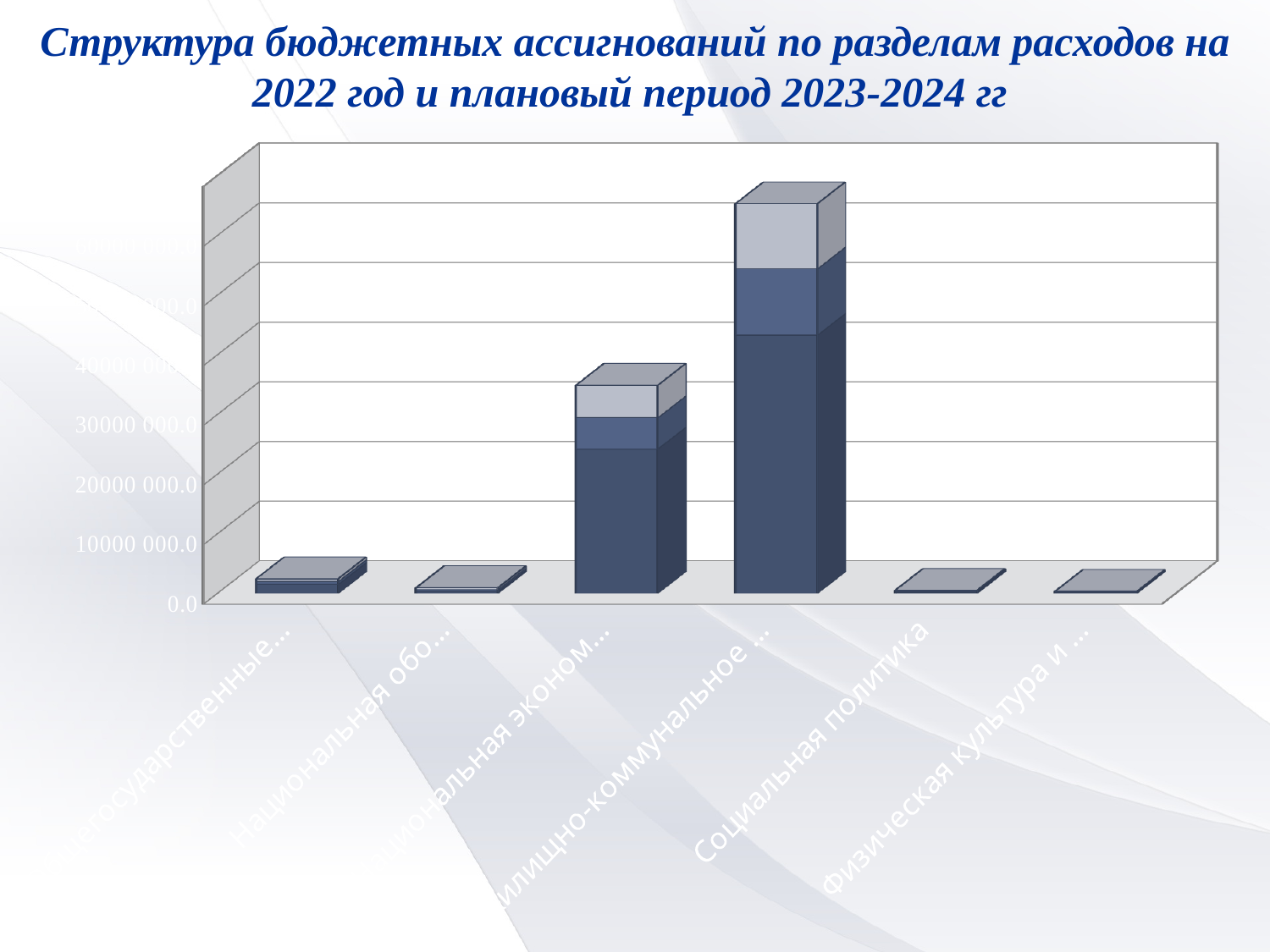
Which stacked bar is taller: "Жилищно-коммунальное ..." or "Национальная эконом..."? Жилищно-коммунальное ... Which category has the tallest stacked bar? Жилищно-коммунальное ... What kind of chart is shown on the slide? bar chart What is the title of the slide above the chart? Структура бюджетных ассигнований по разделам расходов на 2022 год и плановый период 2023-2024 гг How many stacked segments (shades) make up the tallest bar? 3 Which bar is taller: "Социальная политика" or "Национальная эконом..."? Национальная эконом... How many categories (bars) are plotted along the x axis? 6 Is the total height of the "Жилищно-коммунальное ..." bar greater or less than 40000 000.0? greater Is the value for "Социальная политика" greater or less than 10000 000.0? less Is the value for "Общегосударственные..." greater or less than 10000 000.0? less